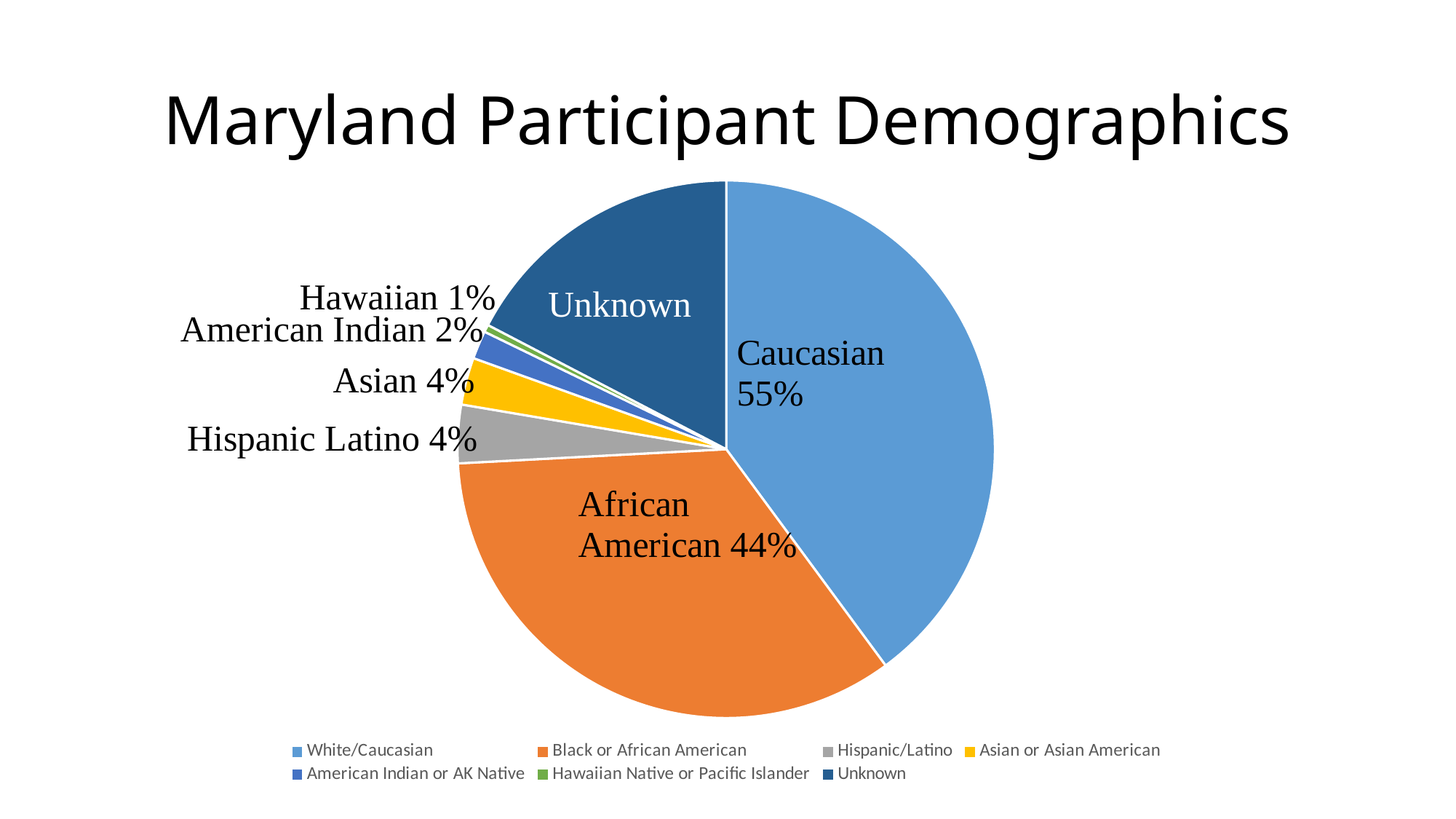
What percentage is shown for the American Indian slice? 2% What percentage is shown for the Hawaiian slice? 1% What percentage is shown for the Caucasian slice? 55% What is the title of the slide? Maryland Participant Demographics What type of chart is shown on the slide? Pie chart Which slice is larger, Caucasian or Unknown? Caucasian What percentage is shown for the African American slice? 44% How many categories does the legend list? 7 What is the difference in percentage points between the Caucasian and African American slices? 11 Which category has the largest slice of the pie? Caucasian Which labelled category has the smallest percentage? Hawaiian What percentage is shown for the Asian slice? 4%